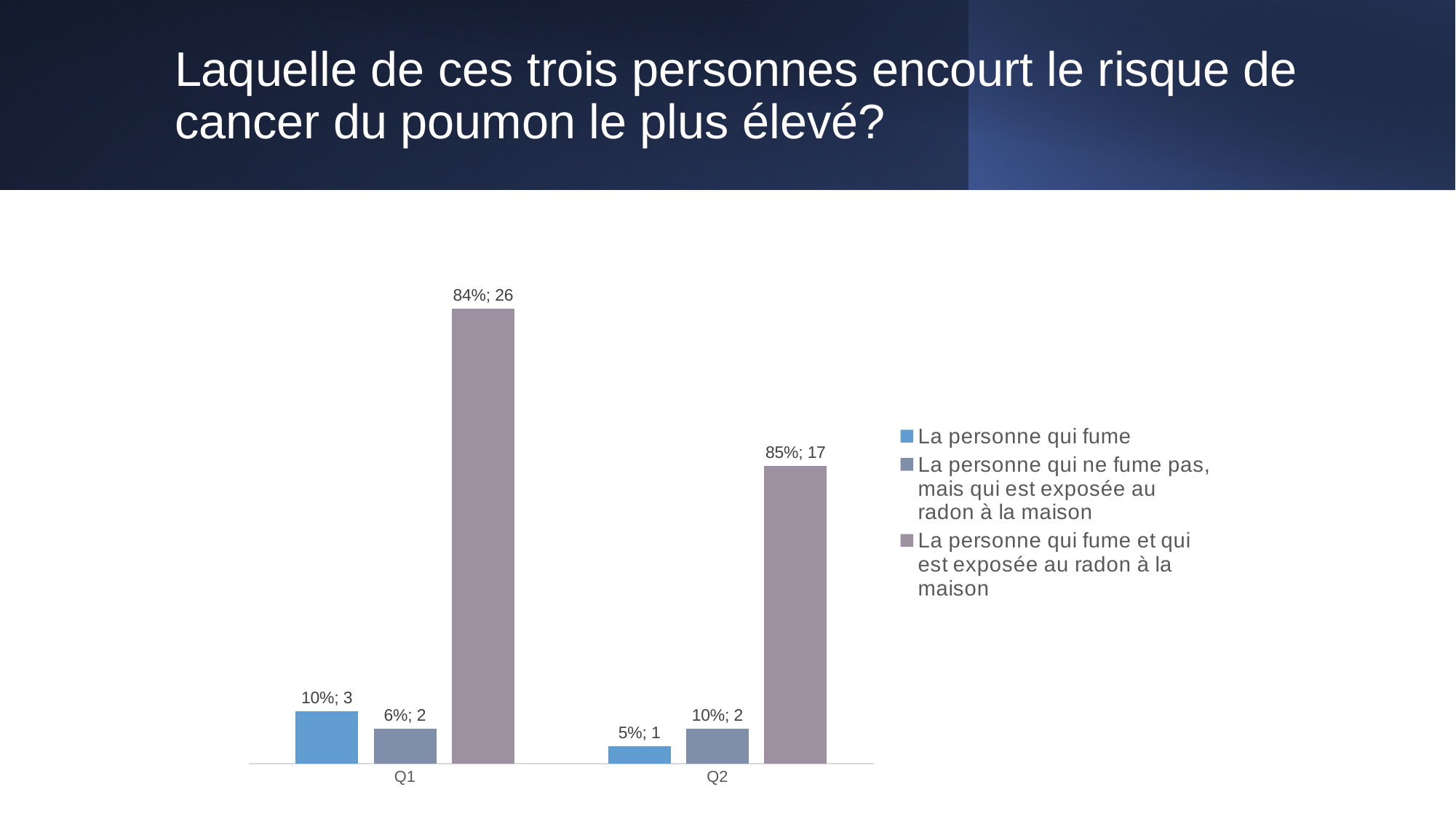
What is the data label for "La personne qui fume et qui est exposée au radon à la maison" in Q1? 84%; 26 What is the data label for "La personne qui fume et qui est exposée au radon à la maison" in Q2? 85%; 17 What kind of chart is shown on the slide? Bar chart How many categories are shown on the x axis? 2 Which series has the lowest value in Q2? La personne qui fume What colour are the bars for "La personne qui fume"? Blue Which is larger: the count for "La personne qui fume" in Q1 or in Q2? Q1 What is the data label for "La personne qui fume" in Q2? 5%; 1 Which series has the highest value in Q1? La personne qui fume et qui est exposée au radon à la maison What is the data label for "La personne qui ne fume pas, mais qui est exposée au radon à la maison" in Q1? 6%; 2 How many series does the legend list? 3 What is the difference in count between "La personne qui fume et qui est exposée au radon à la maison" in Q1 and in Q2? 9